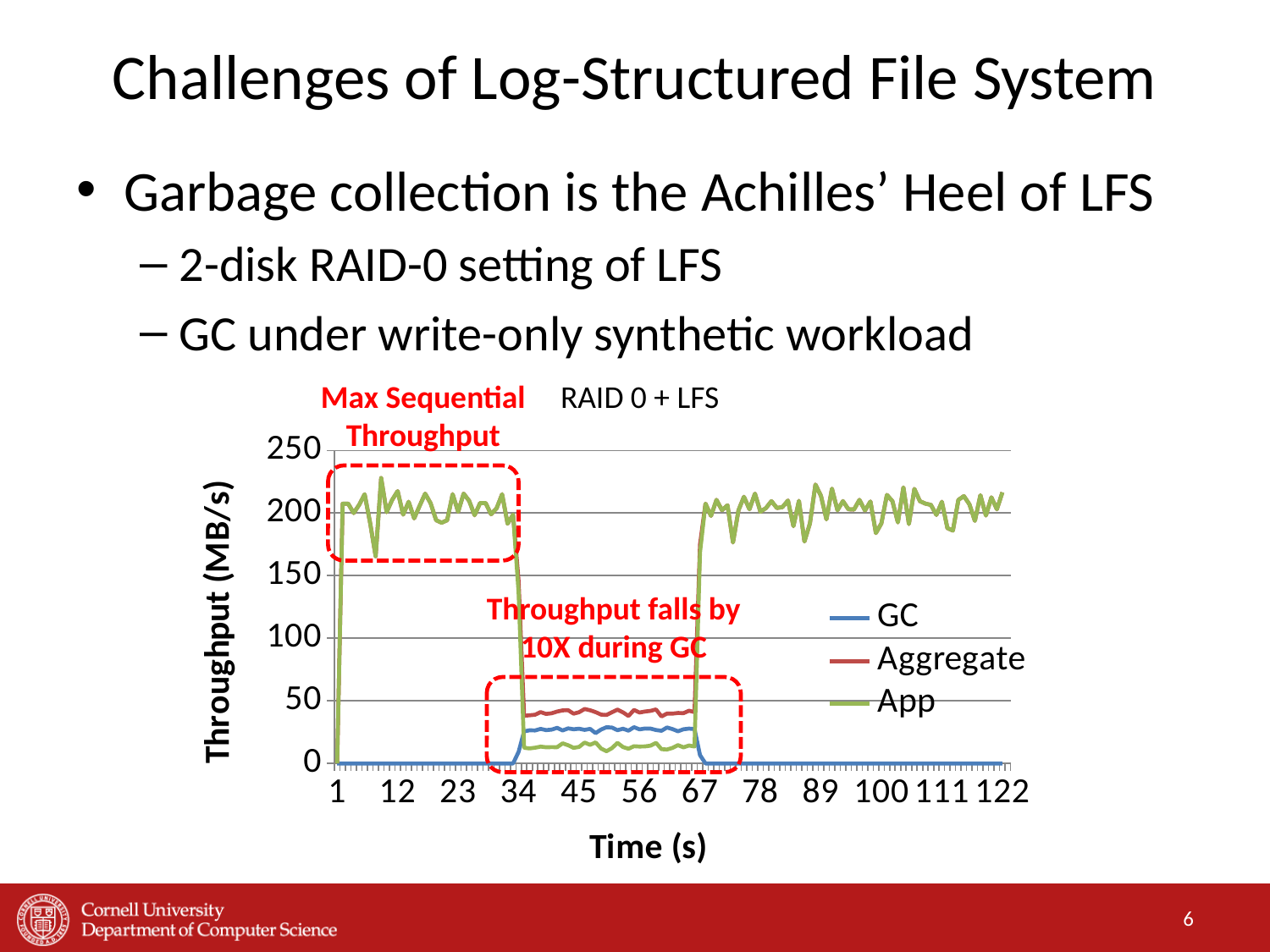
What is the label of the x axis of the chart? Time (s) What are the three series listed in the chart's legend? GC, Aggregate, App How many series does the chart's legend list? 3 Is the App throughput at time 12 s greater or less than 150 MB/s? greater Is the GC throughput at time 45 s greater or less than 50 MB/s? less What kind of chart is shown on the slide? line chart What is the title of the chart? RAID 0 + LFS Between time 34 s and 67 s, which series has the higher throughput, Aggregate or App? Aggregate Is the Aggregate throughput at time 56 s greater or less than 100 MB/s? less Does the App throughput rise or fall as time goes from 23 s to 45 s? fall What is the label of the y axis of the chart? Throughput (MB/s)